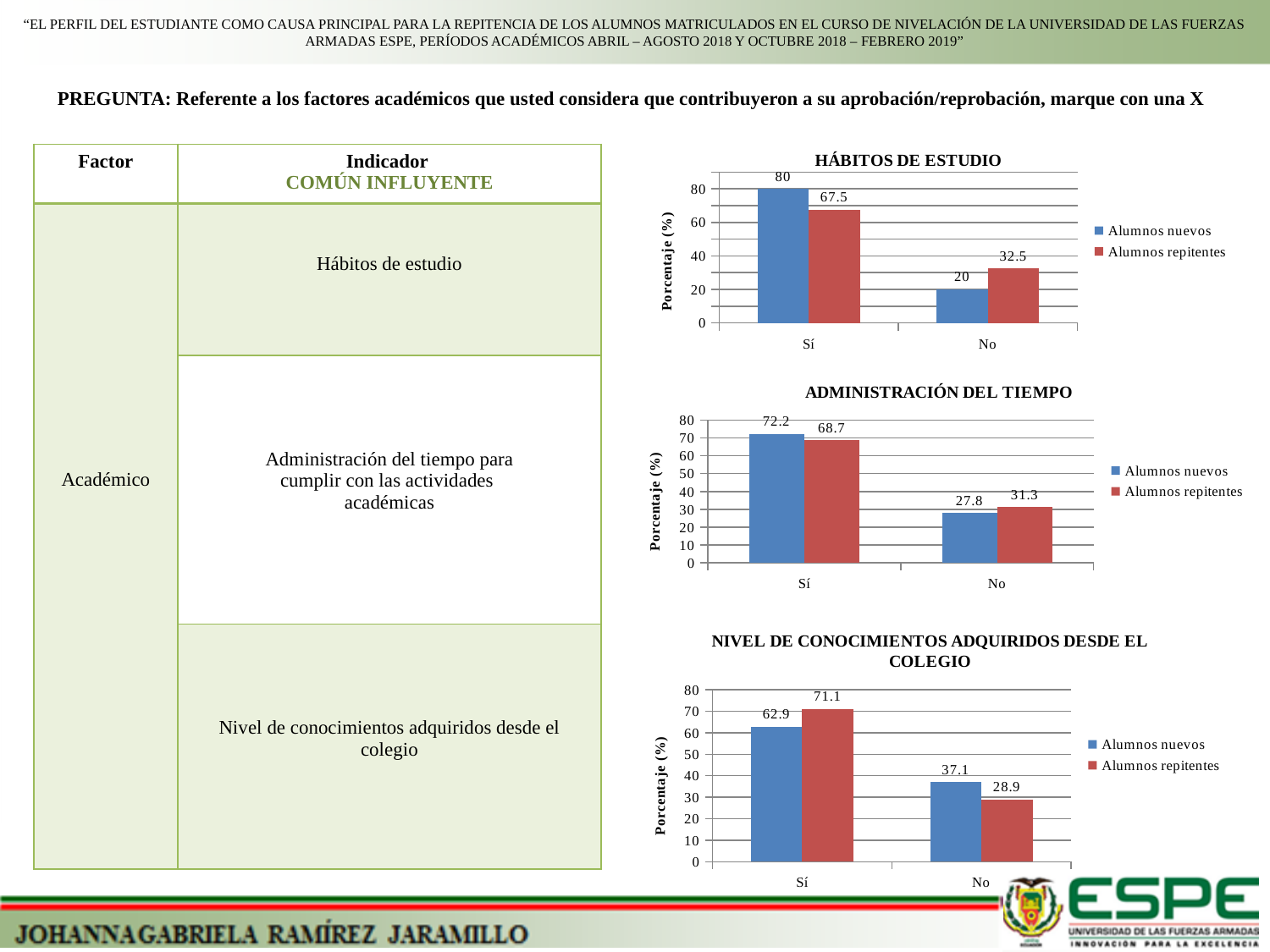
What kind of chart is the 'ADMINISTRACIÓN DEL TIEMPO' chart? Bar chart In the 'NIVEL DE CONOCIMIENTOS ADQUIRIDOS DESDE EL COLEGIO' chart, what is the value for Alumnos repitentes in the Sí category? 71.1 In the 'HÁBITOS DE ESTUDIO' chart, what is the difference between Alumnos nuevos and Alumnos repitentes in the Sí category? 12.5 What is the y-axis label of the 'NIVEL DE CONOCIMIENTOS ADQUIRIDOS DESDE EL COLEGIO' chart? Porcentaje (%) How many series does the legend of the 'HÁBITOS DE ESTUDIO' chart list? 2 In the 'NIVEL DE CONOCIMIENTOS ADQUIRIDOS DESDE EL COLEGIO' chart, what is the difference between Alumnos nuevos and Alumnos repitentes in the No category? 8.2 In the 'ADMINISTRACIÓN DEL TIEMPO' chart, which series has the larger value in the No category, Alumnos nuevos or Alumnos repitentes? Alumnos repitentes In the 'NIVEL DE CONOCIMIENTOS ADQUIRIDOS DESDE EL COLEGIO' chart, which series has the larger value in the No category? Alumnos nuevos In the 'ADMINISTRACIÓN DEL TIEMPO' chart, what is the difference between Alumnos repitentes and Alumnos nuevos in the No category? 3.5 In the 'ADMINISTRACIÓN DEL TIEMPO' chart, what is the value for Alumnos nuevos in the Sí category? 72.2 In the 'HÁBITOS DE ESTUDIO' chart, what is the value for Alumnos nuevos in the Sí category? 80 In the 'HÁBITOS DE ESTUDIO' chart, what is the value for Alumnos repitentes in the No category? 32.5